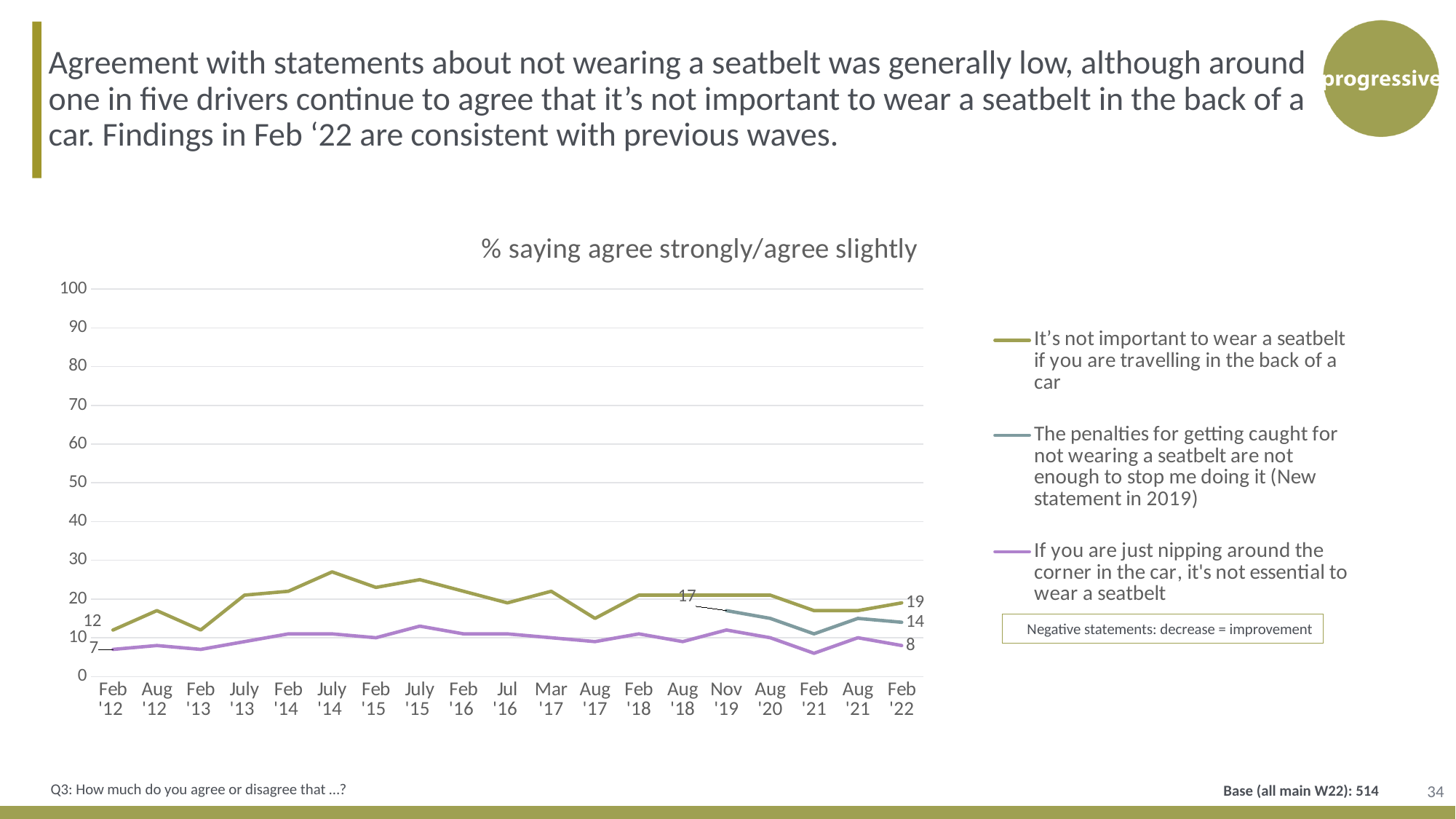
What is the value for 'The penalties for getting caught for not wearing a seatbelt are not enough to stop me doing it' in Nov '19? 17 Which series has the highest value in Feb '22? It's not important to wear a seatbelt if you are travelling in the back of a car Is the value for 'It's not important to wear a seatbelt if you are travelling in the back of a car' in July '14 greater or less than 20? greater By how much did the value for 'It's not important to wear a seatbelt if you are travelling in the back of a car' change from Feb '12 to Feb '22? 7 What is the value for 'The penalties for getting caught for not wearing a seatbelt are not enough to stop me doing it' in Feb '22? 14 How many time points are shown on the x axis? 19 In Feb '22, what is the difference between the 'not important in the back of a car' series and the 'just nipping around the corner' series? 11 What kind of chart is shown on the slide? line chart How many series does the legend list? 3 What is the value for 'It's not important to wear a seatbelt if you are travelling in the back of a car' in Feb '12? 12 What is the value for 'If you are just nipping around the corner in the car, it's not essential to wear a seatbelt' in Feb '22? 8 What is the value for 'It's not important to wear a seatbelt if you are travelling in the back of a car' in Feb '22? 19